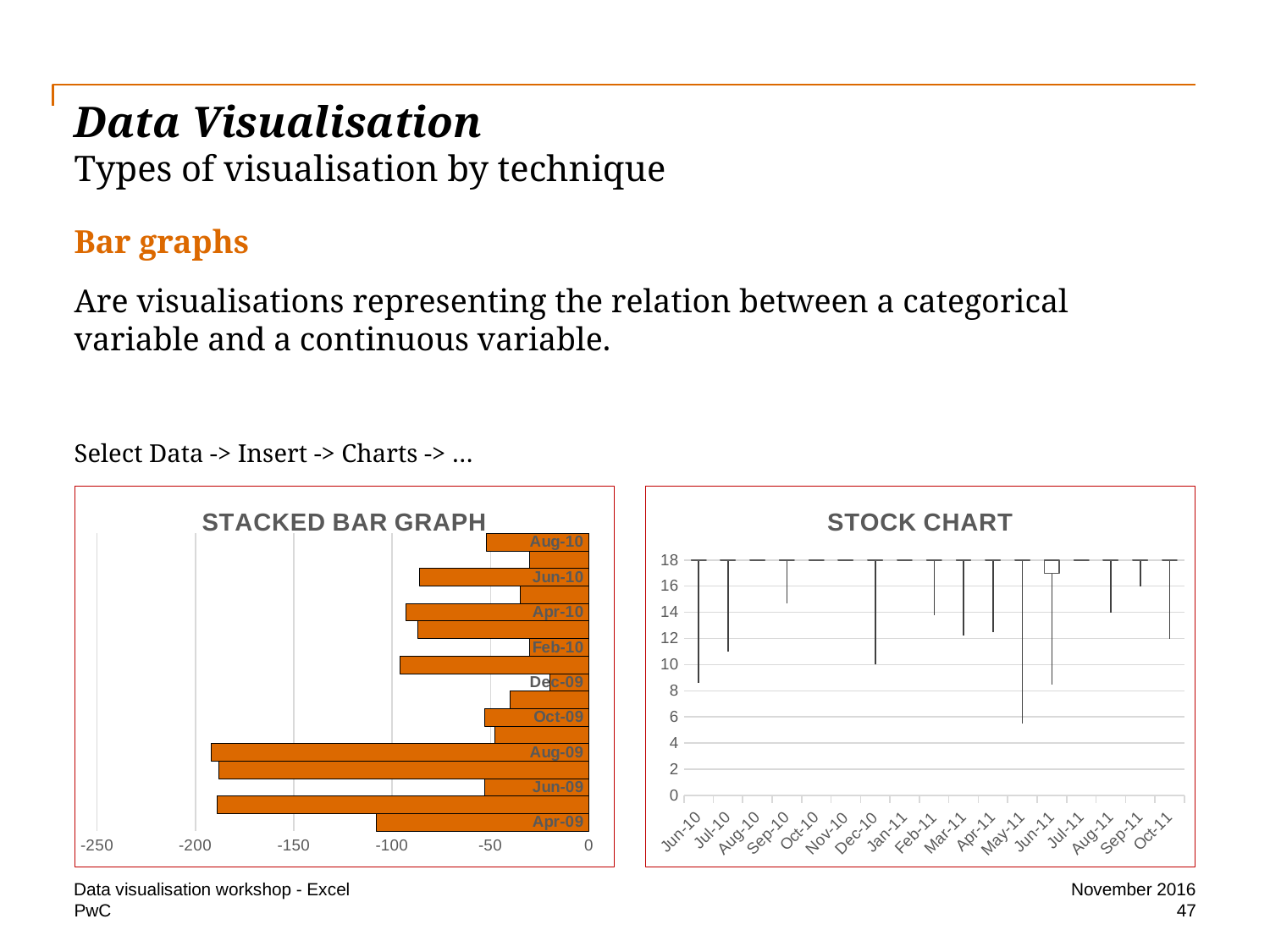
In the STOCK CHART, which month has the lowest low value? May-11 What kind of chart is the chart on the right of the slide? stock chart What kind of chart is the chart titled STACKED BAR GRAPH? bar chart In the STACKED BAR GRAPH, is the value for Feb-10 greater or less than -50? greater In the STACKED BAR GRAPH, is the value for Aug-09 greater or less than -150? less In the STACKED BAR GRAPH, which labelled category has the longest bar (the most negative value)? Aug-09 In the STACKED BAR GRAPH, is the value for Jun-10 greater or less than -100? greater In the STACKED BAR GRAPH, which labelled category has the shortest bar? Dec-09 In the STACKED BAR GRAPH, which bar is longer, Aug-09 or Jun-10? Aug-09 In the STOCK CHART, how many months are shown on the x axis? 17 What colour are the bars in the STACKED BAR GRAPH? orange